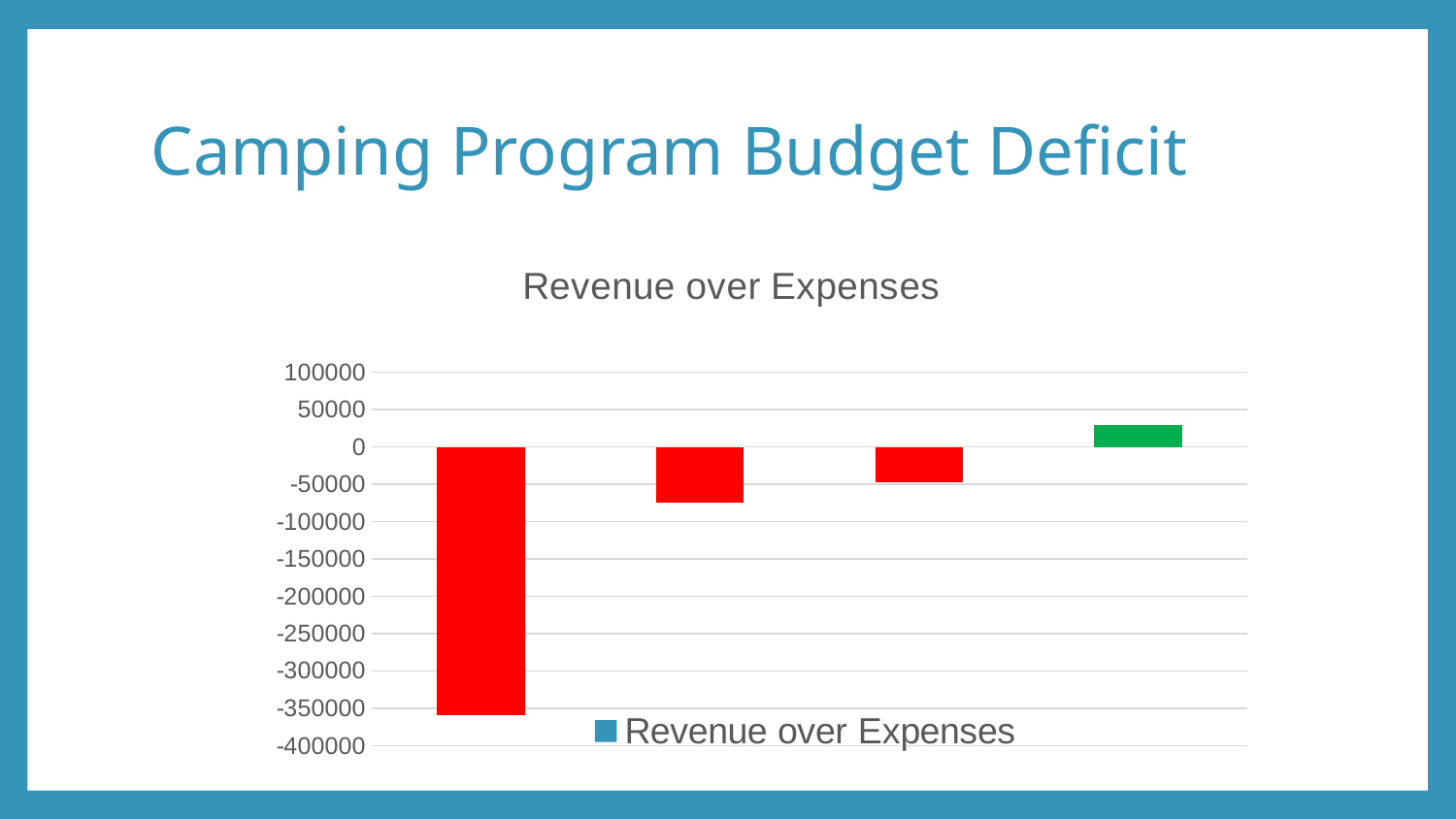
Which of the two is larger: the value of the first bar or the value of the second bar? the second bar Do the bar values rise or fall from left to right across the chart? rise How many bars are plotted in the chart? 4 Which bar, by position from left to right, has the highest value? the fourth bar Is the value of the third bar greater or less than -100000? greater Is the value of the first (leftmost) bar greater or less than -300000? less What is the title of the chart? Revenue over Expenses What kind of chart is shown on the slide? bar chart Which bar, by position from left to right, has the lowest value? the first bar Is the value of the fourth (rightmost) bar greater or less than 0? greater How many series does the legend list? 1